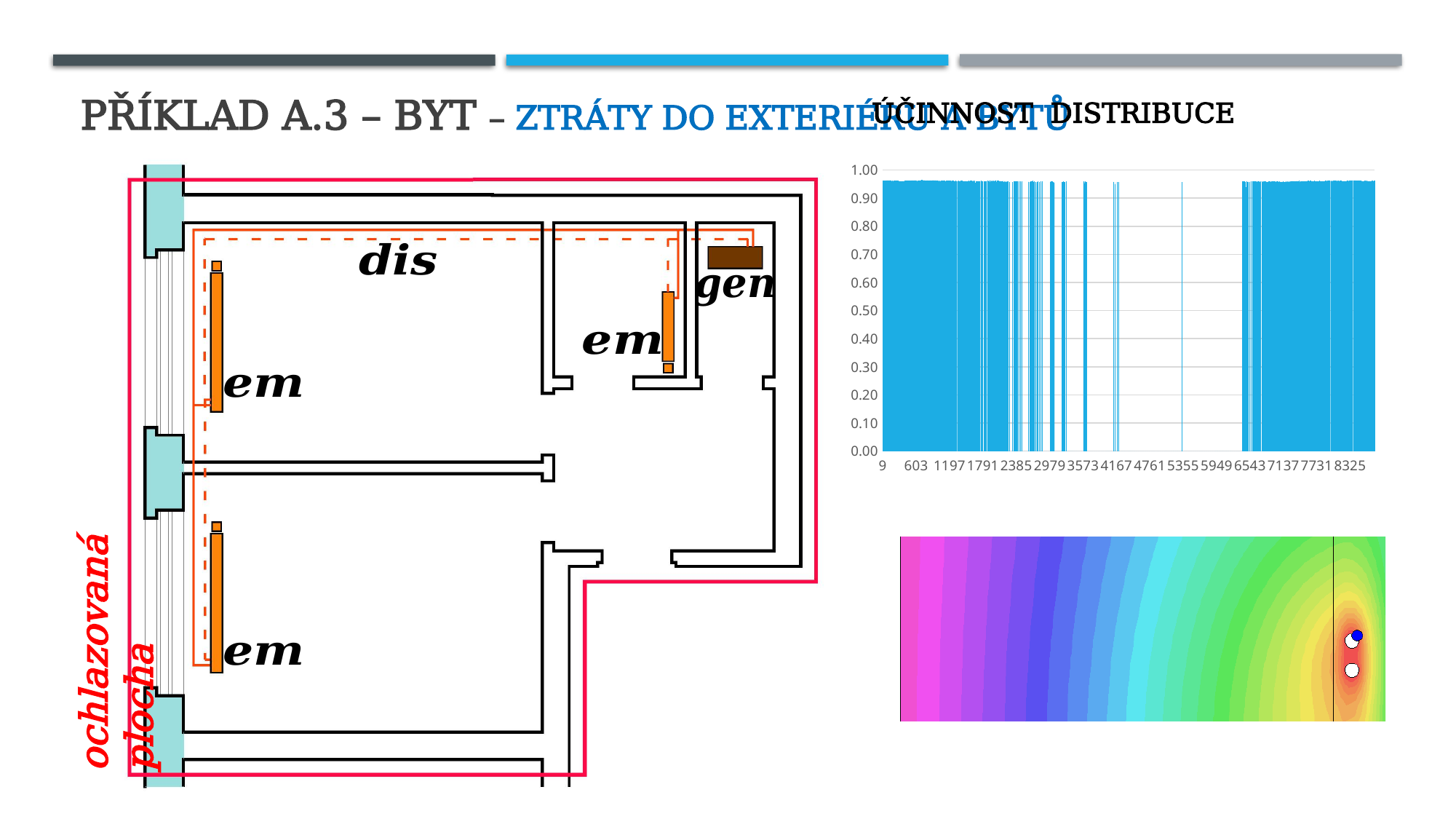
How many tick labels are printed on the x axis of the "ÚČINNOST DISTRIBUCE" chart? 15 What kind of chart is shown under the title "ÚČINNOST DISTRIBUCE"? bar chart In the "ÚČINNOST DISTRIBUCE" chart, do the bars in the region between x = 4167 and x = 5949 mostly reach above 0.90 or are they mostly absent? mostly absent What is the last tick label on the x axis of the "ÚČINNOST DISTRIBUCE" chart? 8325 In the "ÚČINNOST DISTRIBUCE" chart, is the value of the bars at the left end of the x axis greater or less than 0.90? greater In the "ÚČINNOST DISTRIBUCE" chart, is the value of the bars at the right end of the x axis greater or less than 0.90? greater What is the highest value labelled on the y axis of the "ÚČINNOST DISTRIBUCE" chart? 1.00 In the "ÚČINNOST DISTRIBUCE" chart, is the value of the bars near x = 603 greater or less than 0.50? greater What is the first tick label on the x axis of the "ÚČINNOST DISTRIBUCE" chart? 9